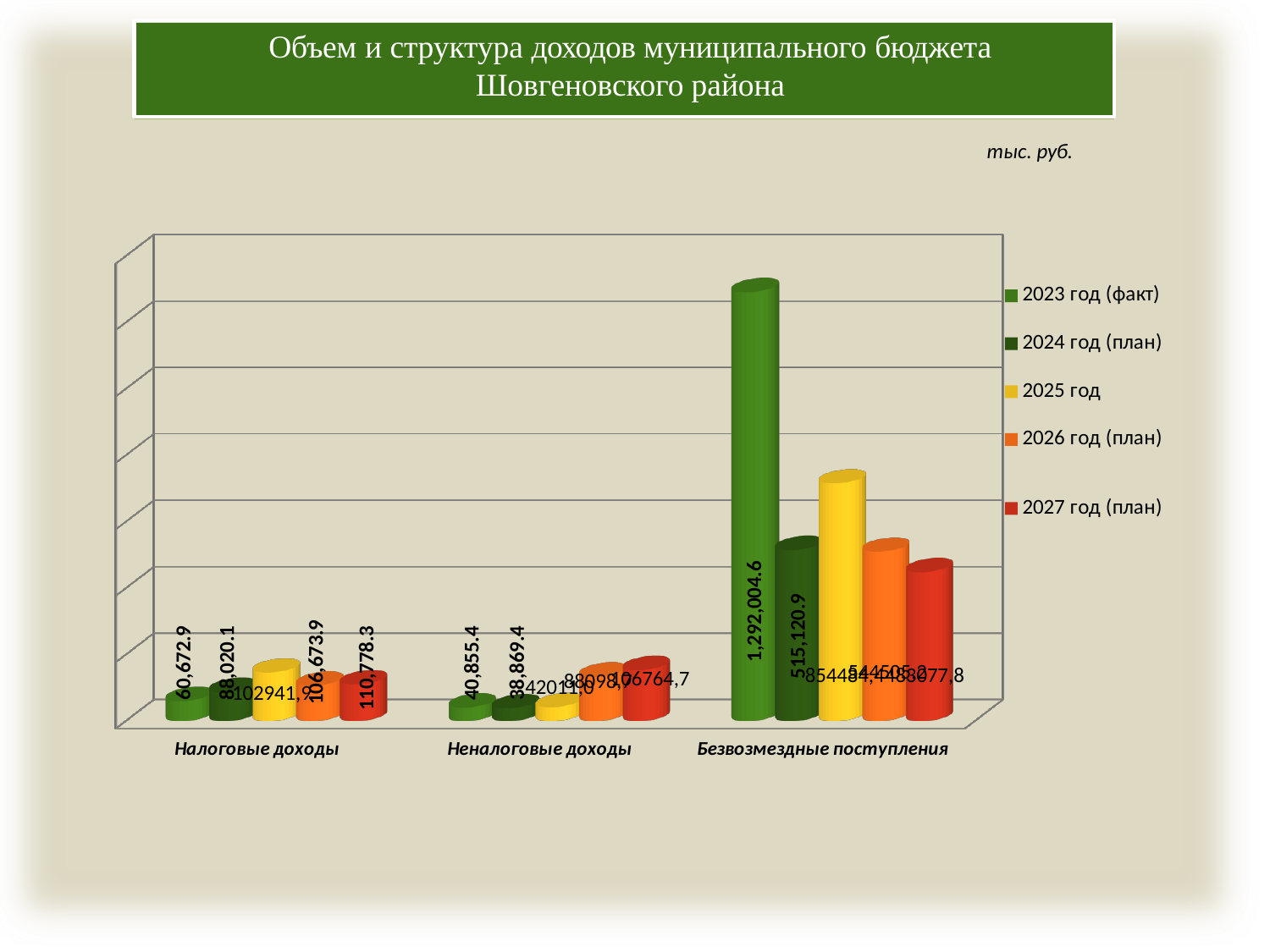
In the Неналоговые доходы category, which is larger: the value for 2023 год (факт) or 2024 год (план)? 2023 год (факт) What is the value for 2024 год (план) in the Неналоговые доходы category? 38,869.4 How many series does the legend list? 5 What is the difference between the 2023 год (факт) and 2024 год (план) values in the Безвозмездные поступления category? 776,883.7 What type of chart is shown on the slide? bar chart What is the value for 2027 год (план) in the Налоговые доходы category? 110,778.3 What is the value for 2023 год (факт) in the Безвозмездные поступления category? 1,292,004.6 How many categories are shown on the x axis? 3 Which series has the lowest value in the Безвозмездные поступления category? 2027 год (план) What is the value for 2024 год (план) in the Безвозмездные поступления category? 515,120.9 What is the value for 2023 год (факт) in the Налоговые доходы category? 60,672.9 Which series has the highest value in the Налоговые доходы category? 2025 год